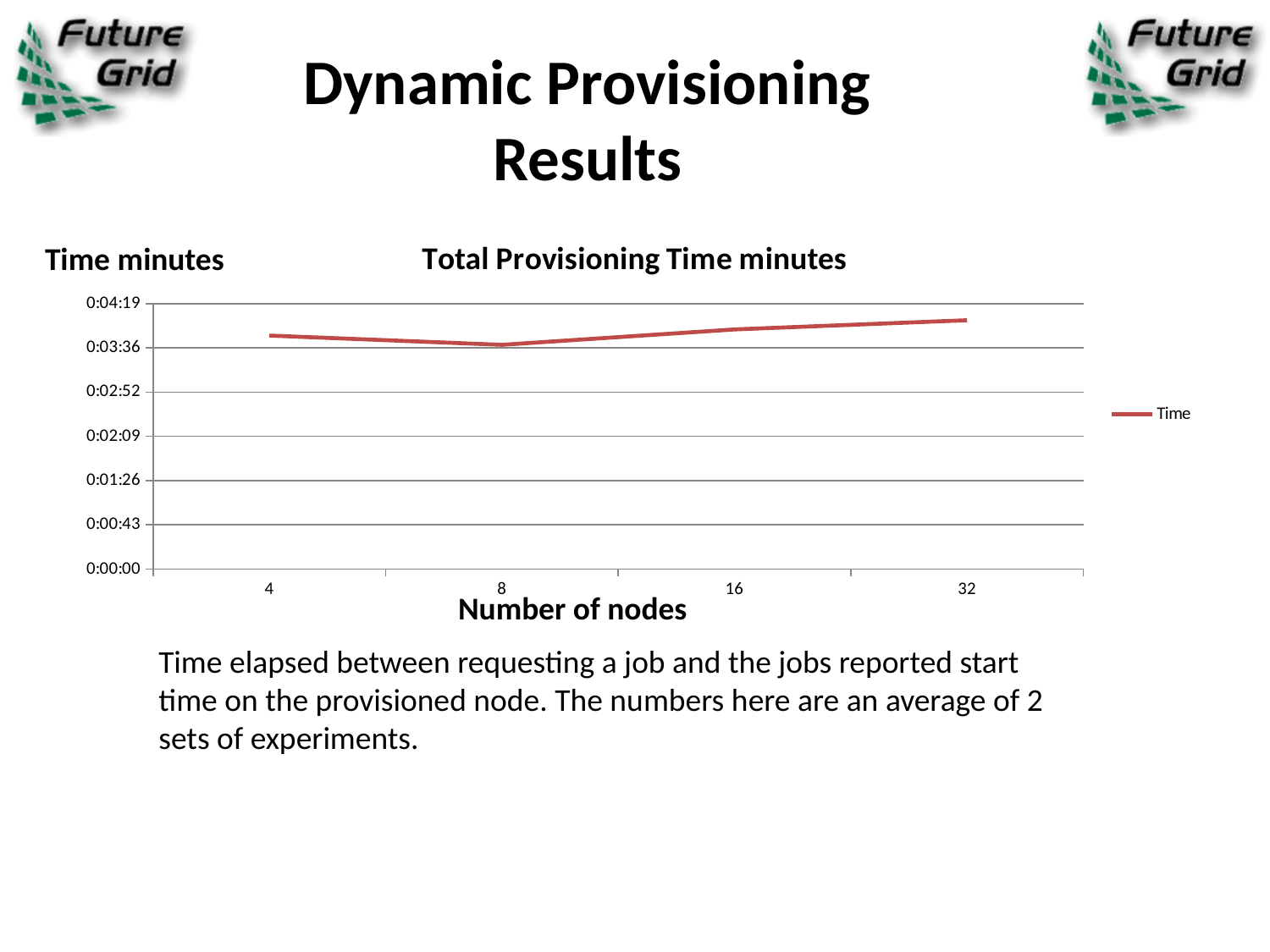
At which number of nodes is the provisioning time highest? 32 How many series does the legend list? 1 What is the title of the chart? Total Provisioning Time minutes How many node counts are plotted along the x axis? 4 What is the name of the series in the legend? Time Is the provisioning time for 4 nodes greater or less than 0:02:52? greater Does the provisioning time rise or fall from 8 nodes to 32 nodes? rise Is the provisioning time for 16 nodes greater or less than 0:04:19? less Which has a larger provisioning time, 8 nodes or 32 nodes? 32 nodes At which number of nodes is the provisioning time lowest? 8 What kind of chart is shown on the slide? line chart Is the provisioning time for 32 nodes greater or less than 0:03:36? greater